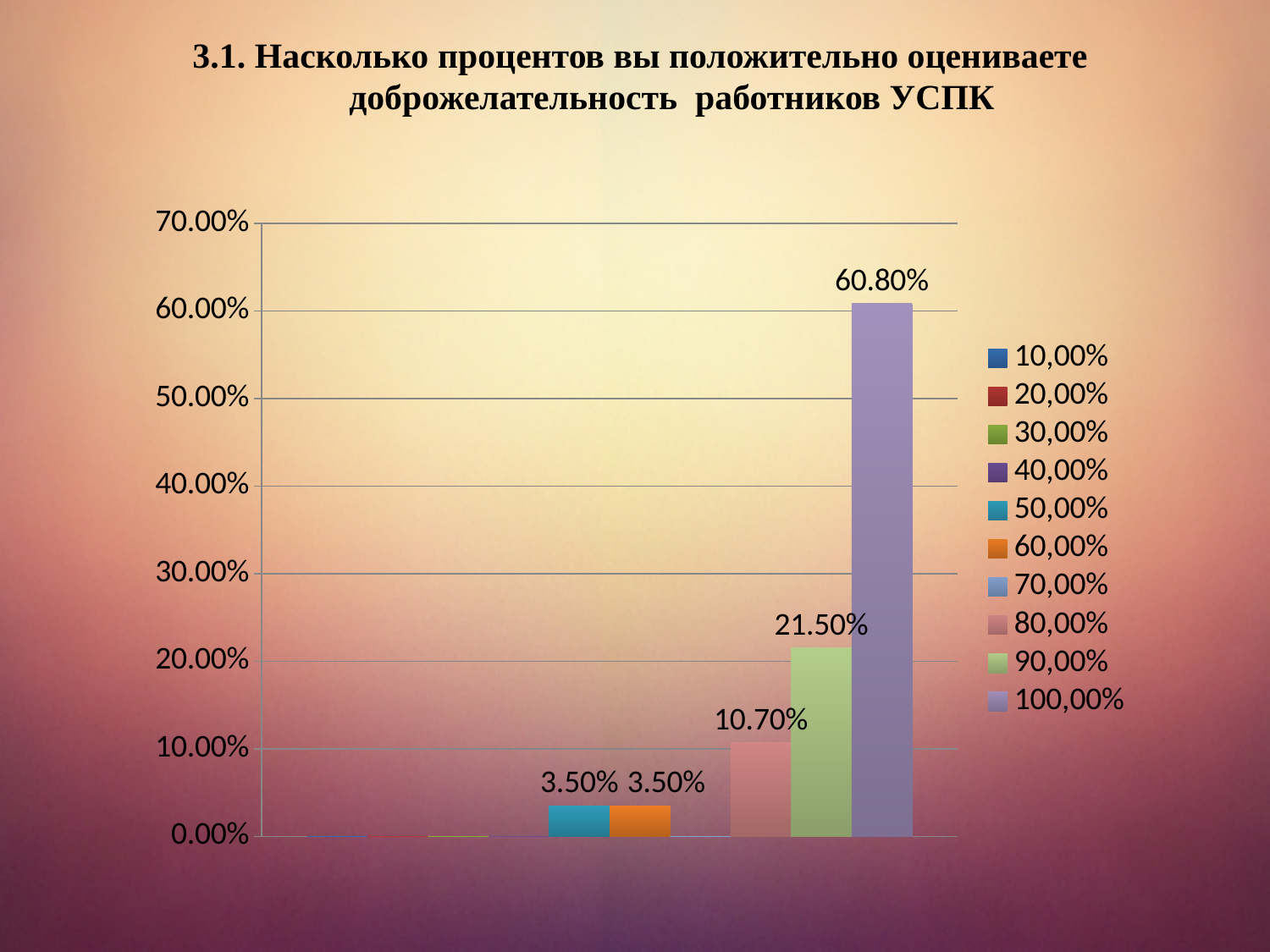
What value is shown for the 90,00% series? 21.50% Which is larger, the value for the 80,00% series or the 60,00% series? 80,00% What value is shown for the 80,00% series? 10.70% Which series has the highest value? 100,00% What colour is the bar for the 100,00% series? purple What is the difference between the values for the 90,00% and 80,00% series? 10.80% How many series does the legend list? 10 What value is shown for the 100,00% series? 60.80% Is the value for the 100,00% series greater or less than 50.00%? greater What value is shown for the 50,00% series? 3.50% What kind of chart is shown on the slide? bar chart What is the difference between the values for the 100,00% and 90,00% series? 39.30%